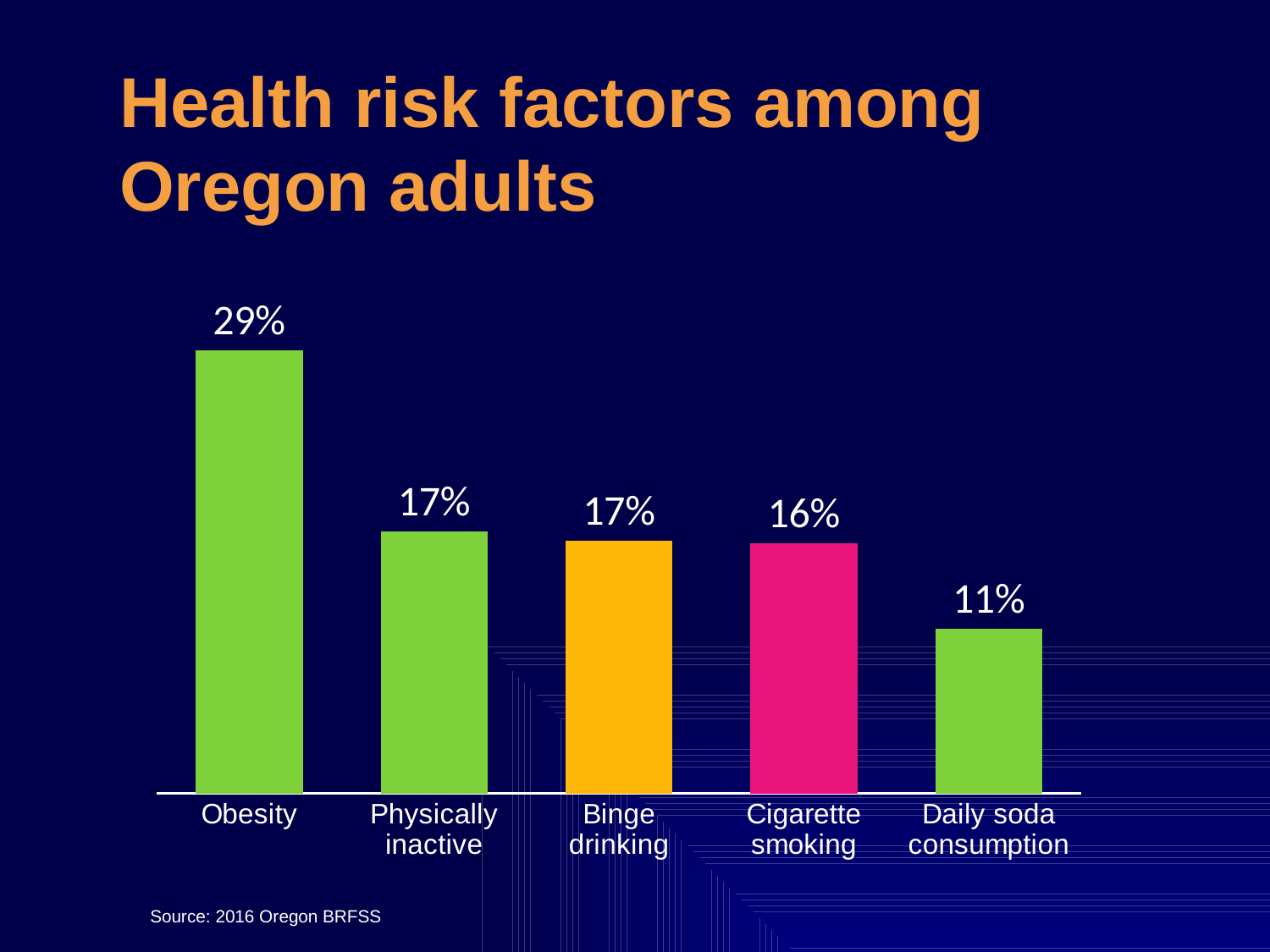
What kind of chart is shown on the slide? Bar chart What is the value for Binge drinking? 17% Which is larger, the value for Obesity or the value for Physically inactive? Obesity How many categories are shown in the chart? 5 What is the title of the slide containing the chart? Health risk factors among Oregon adults Which category has the highest value? Obesity What is the value for Cigarette smoking? 16% Which category has the lowest value? Daily soda consumption What is the difference between the values for Physically inactive and Cigarette smoking? 1% What is the difference between the values for Obesity and Daily soda consumption? 18% What is the value for Obesity? 29% What is the value for Daily soda consumption? 11%